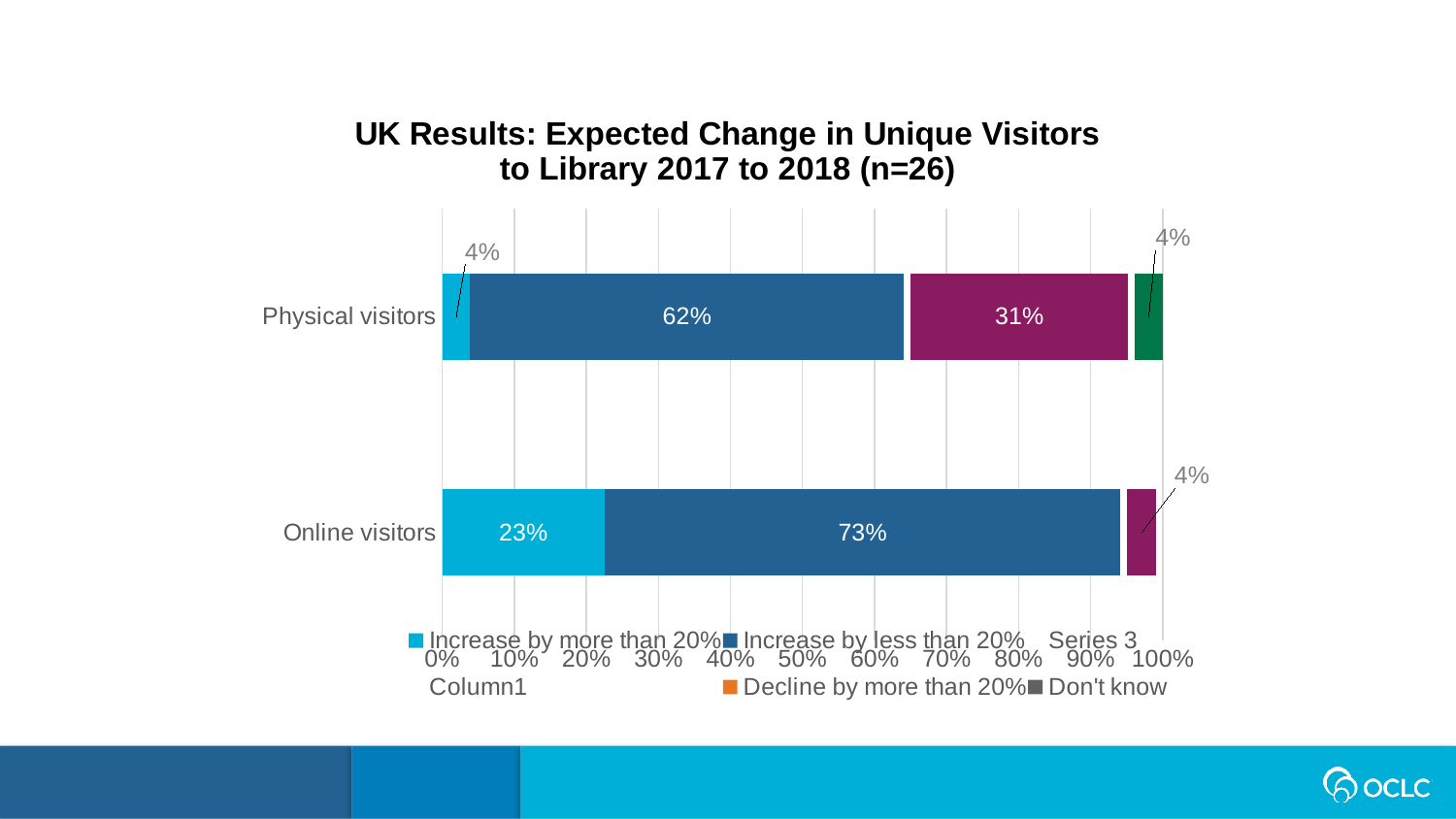
What is the difference between the 'Increase by more than 20%' values for Online visitors and Physical visitors? 19 percentage points What is the total of the labelled segments in the Online visitors bar? 100% What is the value of the 'Increase by less than 20%' segment for Online visitors? 73% What is the value of the 'Increase by more than 20%' segment for Physical visitors? 4% What is the value of the 'Increase by less than 20%' segment for Physical visitors? 62% What kind of chart is shown on the slide? Stacked bar chart Which category has the highest 'Increase by more than 20%' value? Online visitors What is the title of the chart? UK Results: Expected Change in Unique Visitors to Library 2017 to 2018 (n=26) What is the difference between the 'Increase by less than 20%' values for Online visitors and Physical visitors? 11 percentage points How many categories are plotted on the y axis of the chart? 2 Which category has the larger 'Increase by less than 20%' segment, Physical visitors or Online visitors? Online visitors What is the value of the 'Increase by more than 20%' segment for Online visitors? 23%